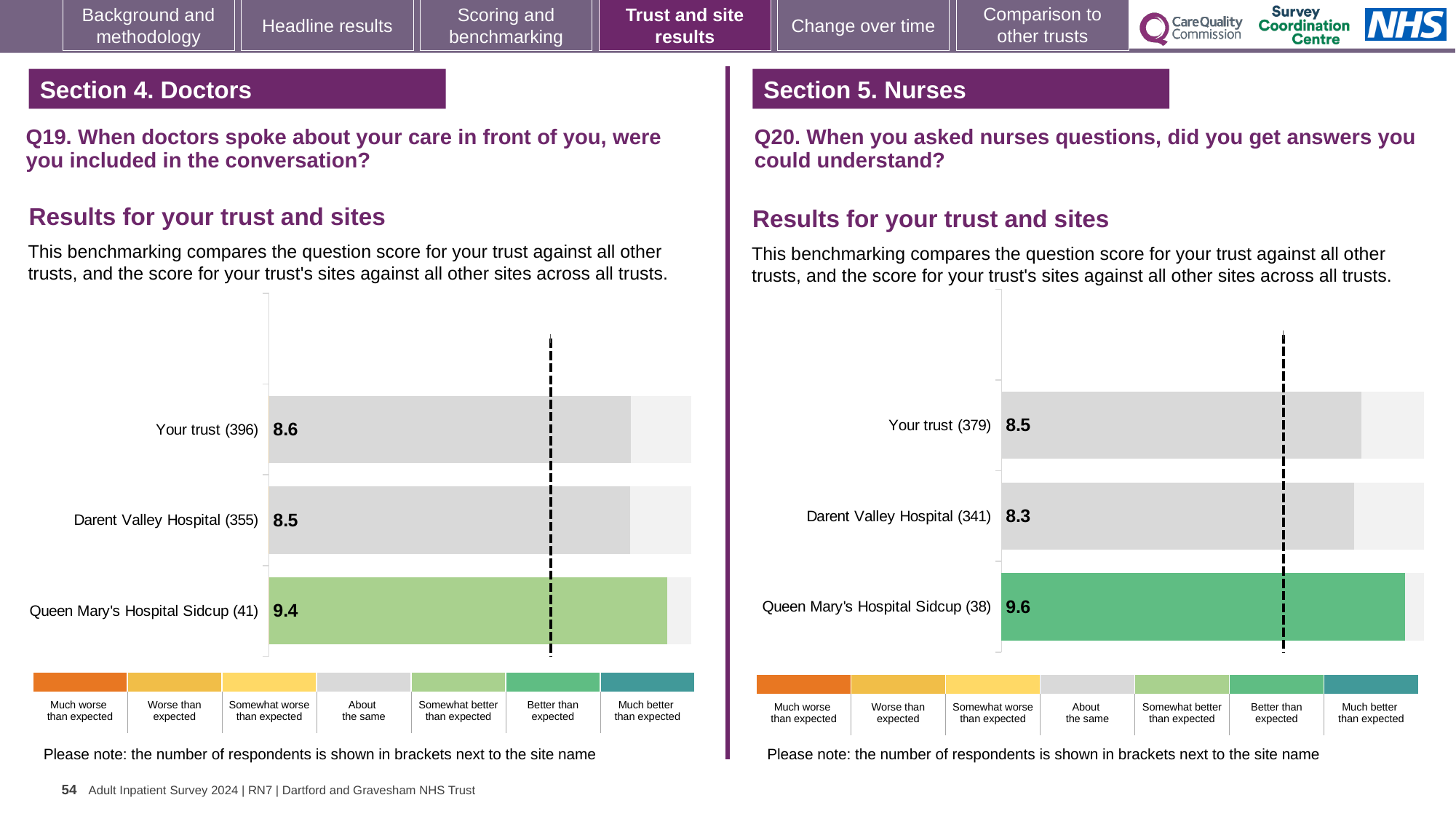
What type of chart is used for the Q20 results (right)? Bar chart In the Q19 chart (left), what is the score for Queen Mary's Hospital Sidcup? 9.4 In the Q20 chart (right), which has the larger score, Your trust or Darent Valley Hospital? Your trust In the Q20 chart (right), what is the score for Queen Mary's Hospital Sidcup? 9.6 In the Q19 chart (left), how many respondents are shown in brackets for Queen Mary's Hospital Sidcup? 41 In the Q20 chart (right), what is the difference between the scores for Queen Mary's Hospital Sidcup and Your trust? 1.1 In the Q20 chart (right), which site or trust has the lowest score? Darent Valley Hospital In the Q19 chart (left), which site or trust has the highest score? Queen Mary's Hospital Sidcup In the Q20 chart (right), what is the score for Darent Valley Hospital? 8.3 In the Q19 chart (left), what is the difference between the scores for Queen Mary's Hospital Sidcup and Darent Valley Hospital? 0.9 How many bars are plotted in the Q19 chart (left)? 3 In the Q19 chart (left), what is the score for Your trust? 8.6